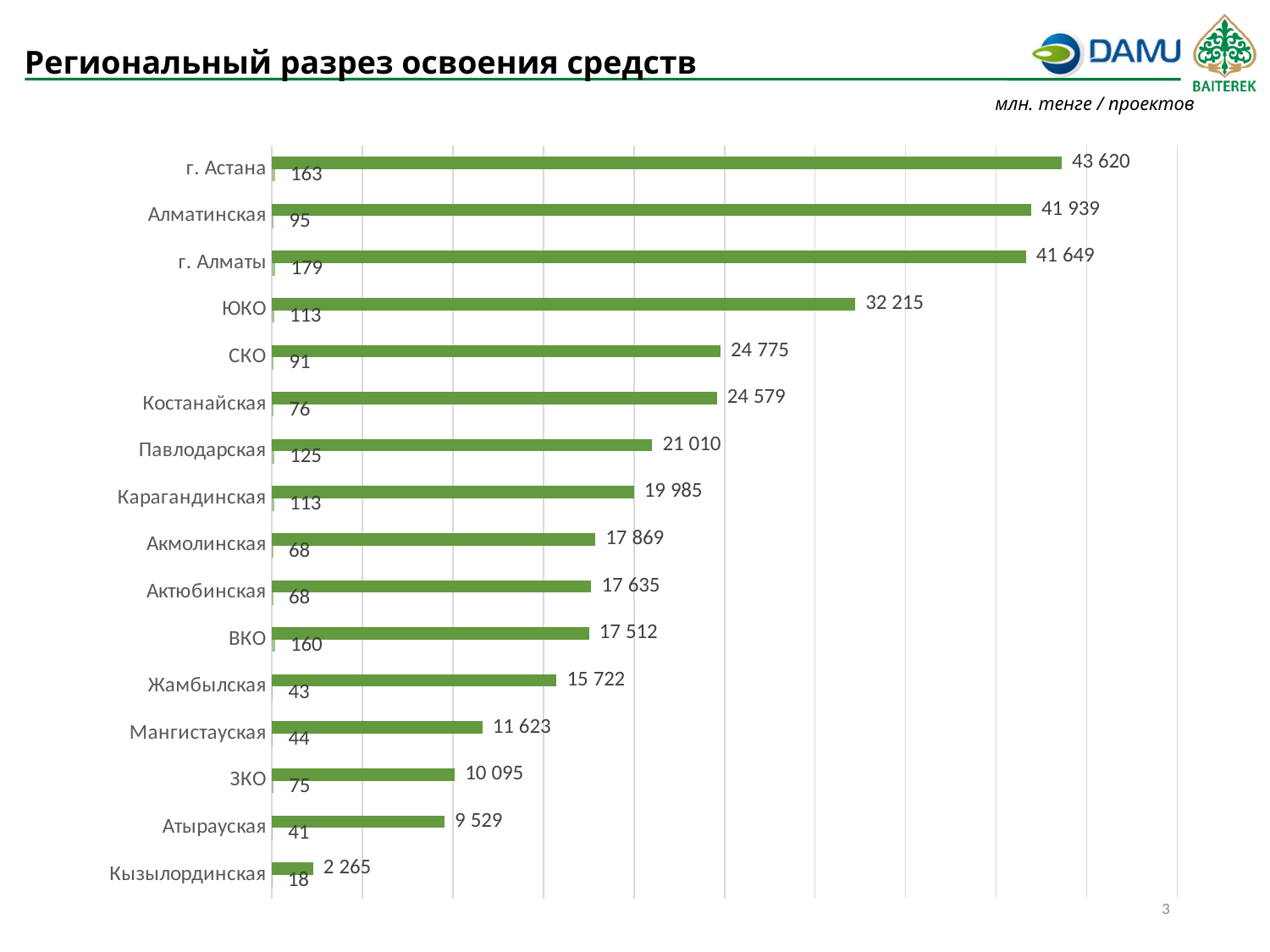
Which has a larger amount in million tenge, ЮКО or СКО? ЮКО Which region has the highest amount in million tenge? г. Астана Which region has the lowest amount in million tenge? Кызылординская What is the title of the chart on the slide? Региональный разрез освоения средств What is the amount in million tenge for Костанайская? 24 579 What kind of chart is shown on the slide? Bar chart What is the amount in million tenge for г. Астана? 43 620 Which region has the lowest number of projects? Кызылординская How many projects are shown for г. Алматы? 179 How many regions are listed on the chart? 16 Which has more projects, ВКО or Жамбылская? ВКО What is the difference in million tenge between г. Астана and Алматинская? 1 681